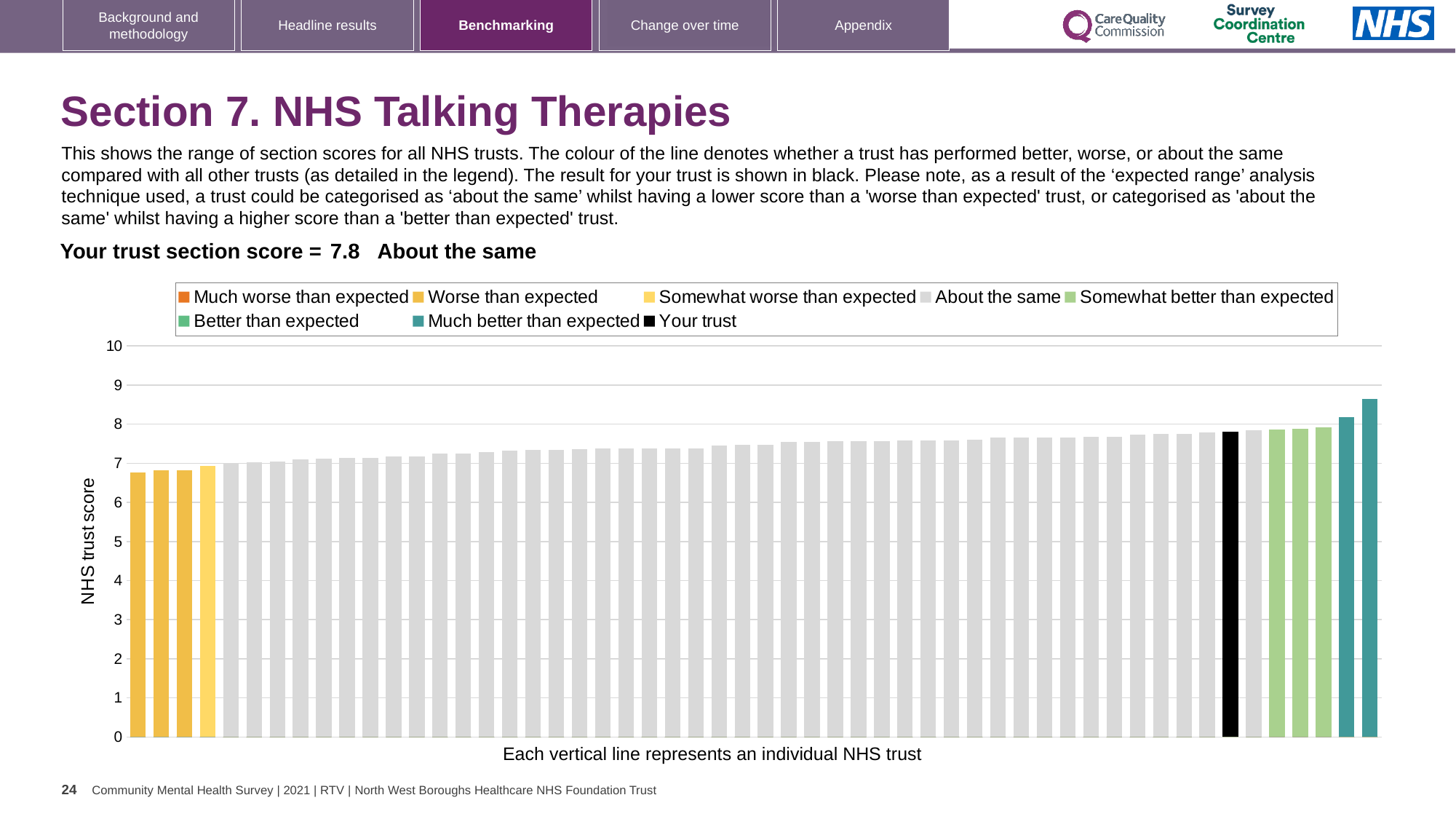
Is the value of the leftmost bar greater or less than 7? less How many bars are coloured teal (Much better than expected)? 2 What is the section score for your trust shown on the slide? 7.8 What colour is the bar representing your trust? Black What kind of chart is shown on the slide? Bar chart What is the title of the vertical axis? NHS trust score Is the value of the tallest bar greater or less than 8? greater How many entries does the chart legend list? 8 Which category is your trust placed in for this section? About the same Is the value of the black 'Your trust' bar greater or less than 7? greater Which legend category does the tallest bar belong to? Much better than expected Do the bar values rise or fall from left to right along the x axis? Rise